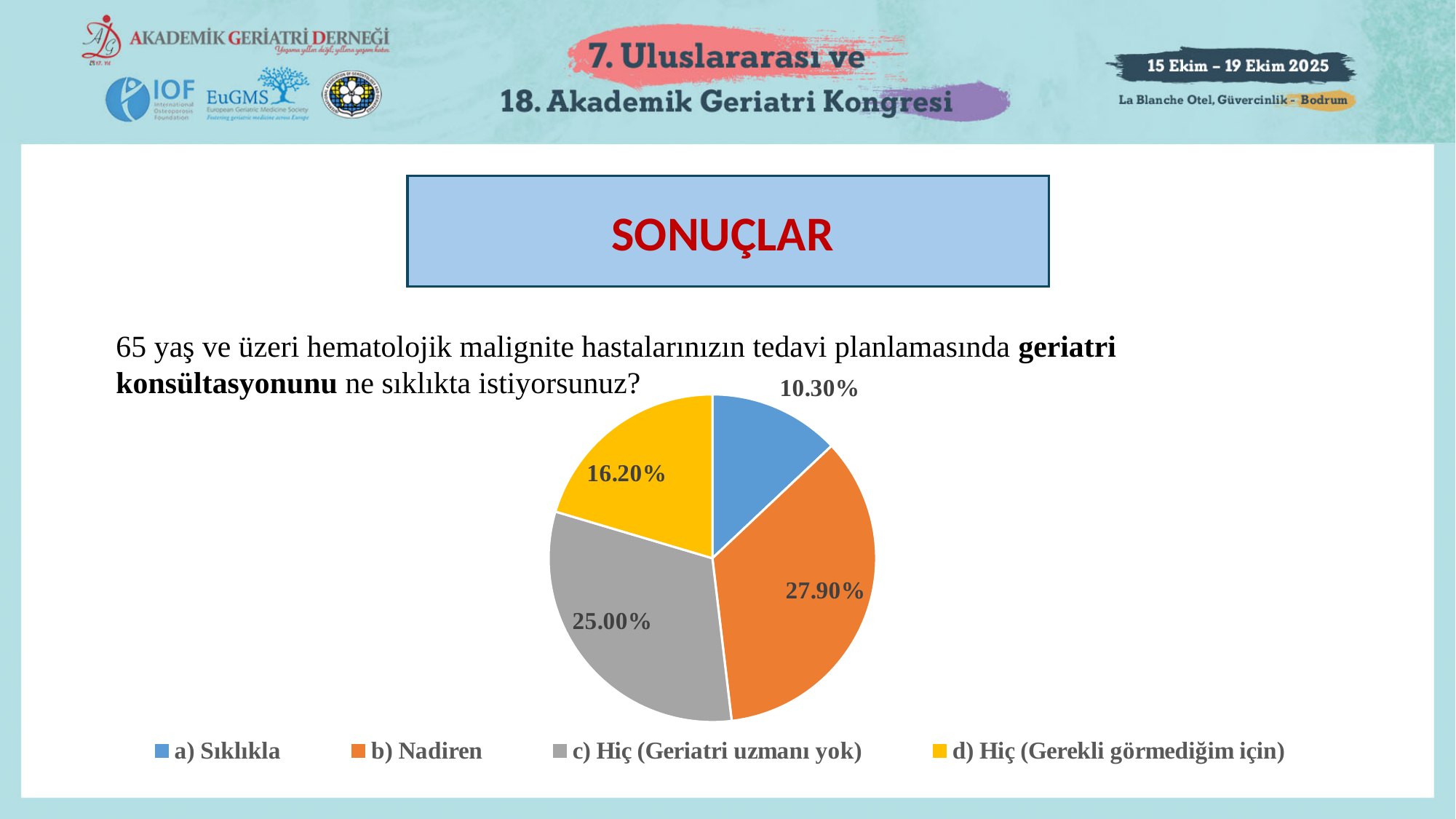
Which is larger, the slice for "c) Hiç (Geriatri uzmanı yok)" or the slice for "d) Hiç (Gerekli görmediğim için)"? c) Hiç (Geriatri uzmanı yok) How many categories does the pie chart have? 4 What colour is the slice for "b) Nadiren"? orange What percentage is shown for "b) Nadiren"? 27.90% Which category has the smallest slice of the pie? a) Sıklıkla What percentage is shown for "d) Hiç (Gerekli görmediğim için)"? 16.20% Which category has the largest slice of the pie? b) Nadiren What is the difference between the percentages for "c) Hiç (Geriatri uzmanı yok)" and "d) Hiç (Gerekli görmediğim için)"? 8.80% What is the difference between the percentages for "b) Nadiren" and "a) Sıklıkla"? 17.60% What kind of chart is shown on the slide? pie chart What percentage is shown for "c) Hiç (Geriatri uzmanı yok)"? 25.00% What percentage is shown for "a) Sıklıkla"? 10.30%